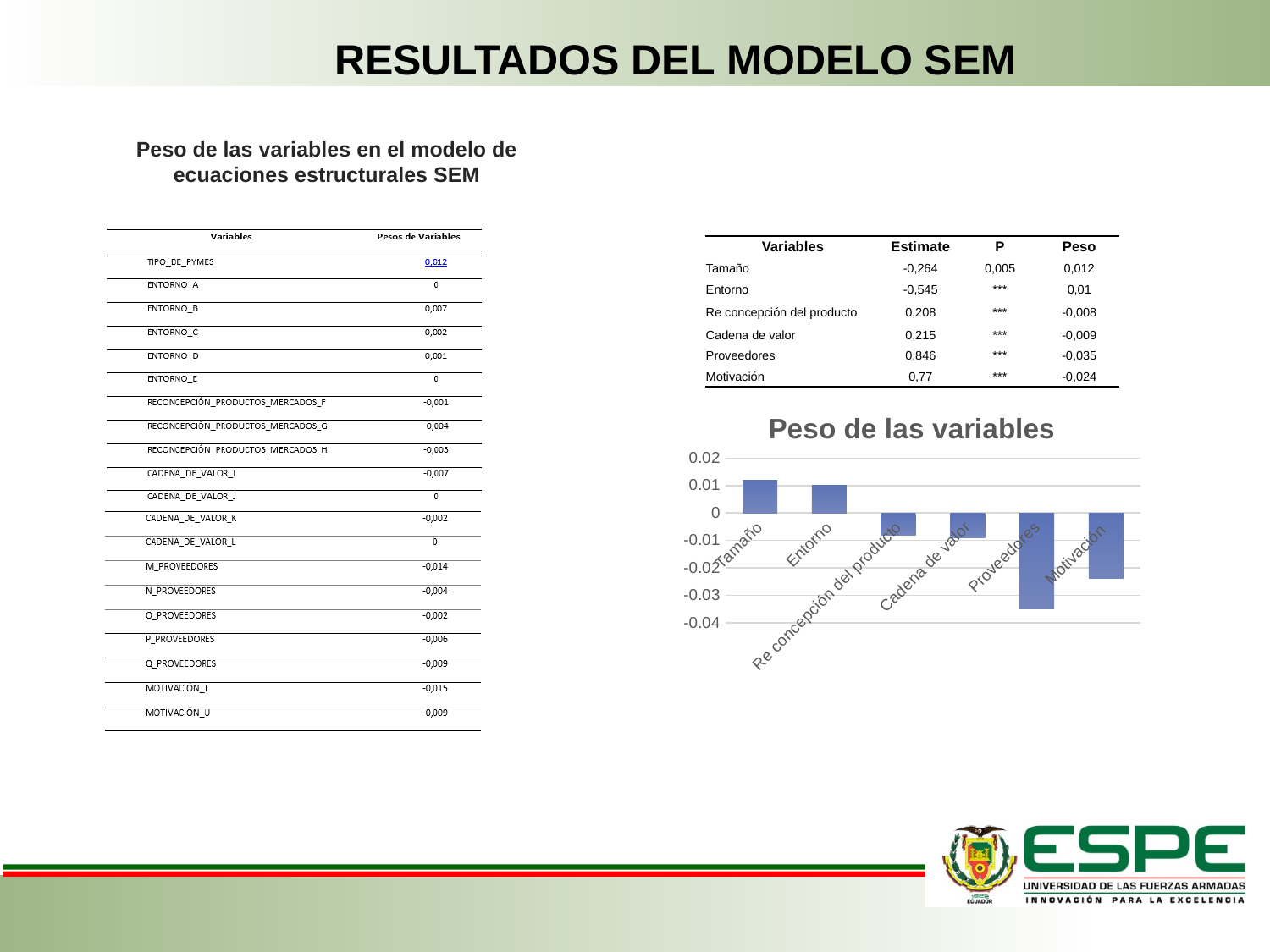
Which category has the lowest value in the "Peso de las variables" chart? Proveedores According to the Peso column of the table next to the chart, what is the value plotted for Proveedores in the "Peso de las variables" chart? -0,035 What is the lowest value shown on the vertical axis of the "Peso de las variables" chart? -0.04 How many categories are shown in the "Peso de las variables" chart? 6 In the "Peso de las variables" chart, which is larger, the value for Motivación or the value for Proveedores? Motivación In the "Peso de las variables" chart, which is larger, the value for Tamaño or the value for Re concepción del producto? Tamaño In the "Peso de las variables" chart, is the value for Tamaño greater or less than 0? greater What is the title of the bar chart on the slide? Peso de las variables In the "Peso de las variables" chart, is the value for Proveedores greater or less than -0.03? less What kind of chart is "Peso de las variables"? bar chart In the "Peso de las variables" chart, is the value for Motivación greater or less than -0.02? less How many bars in the "Peso de las variables" chart have negative values? 4